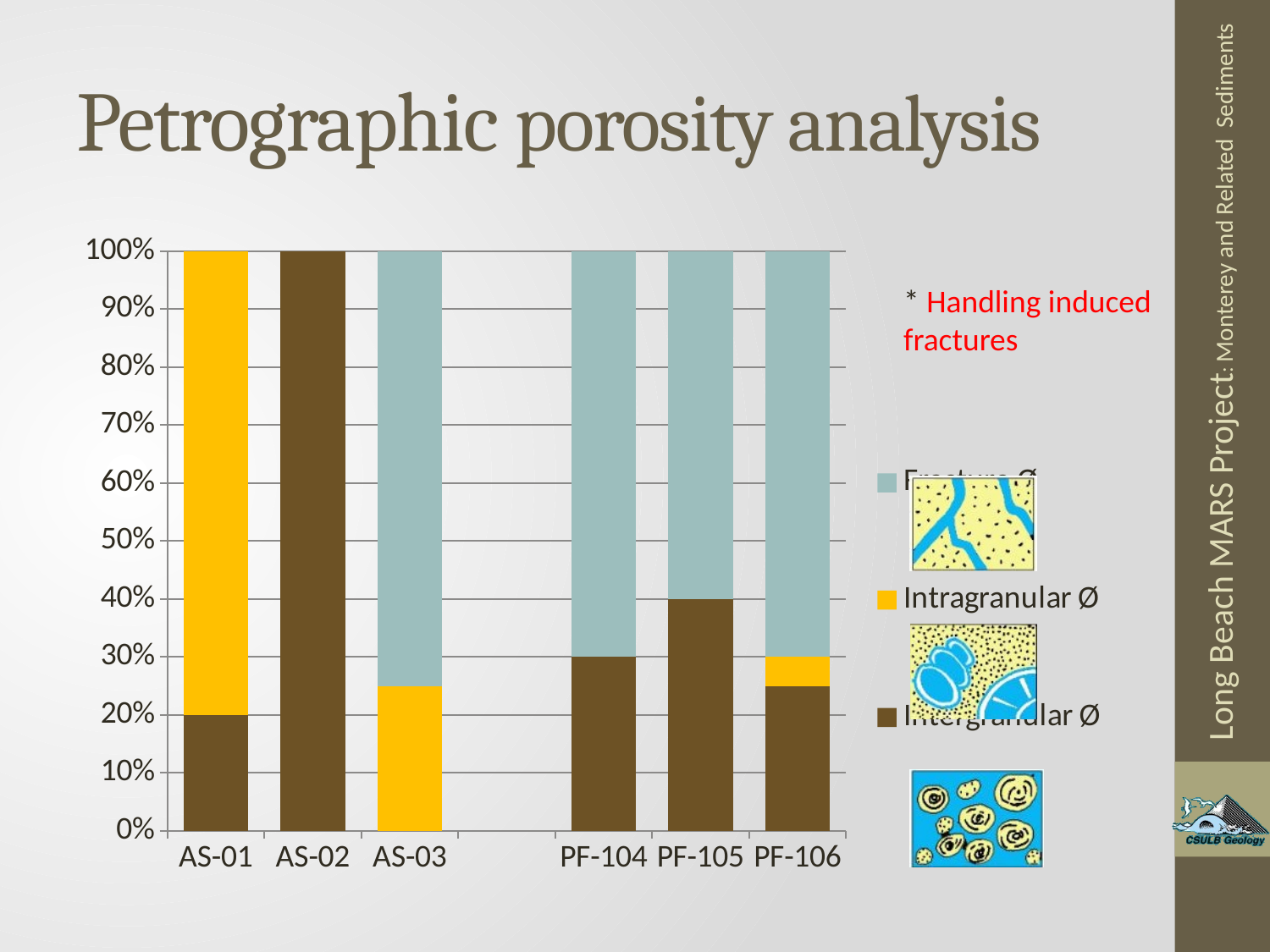
Which sample has the highest Intergranular Ø share? AS-02 What is the difference between the Intergranular Ø shares of PF-105 and PF-104? 10% What kind of chart is shown on the slide? Stacked bar chart How many sample categories are shown on the x axis of the chart? 6 What is the Intergranular Ø value for PF-105? 40% Is the Intragranular Ø share for AS-03 greater or less than 30%? less What is the Intergranular Ø value for PF-104? 30% What is the Intergranular Ø value for AS-01? 20% How many series does the chart's legend list? 3 Which has the larger Intergranular Ø share, PF-104 or PF-105? PF-105 What is the Intergranular Ø value for AS-02? 100% Which sample has no Intergranular Ø segment at all? AS-03